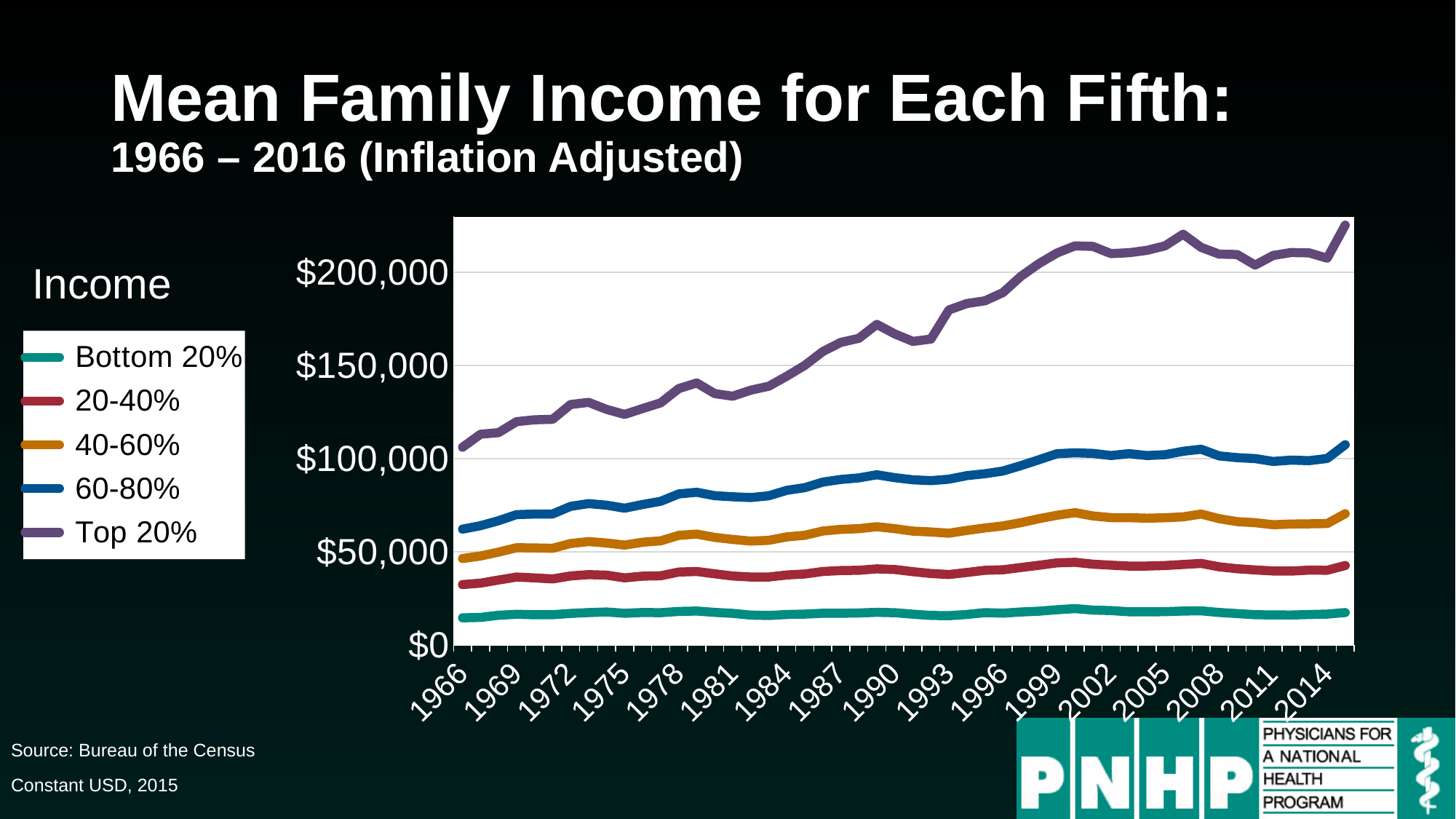
How many series does the legend list? 5 What is the title of the legend on the slide? Income Is the value for the 40-60% group in 2016 greater or less than $100,000? less Which income group has the lowest mean family income across the whole period? Bottom 20% Is the value for the 60-80% group in 1966 greater or less than $100,000? less Which is larger in 2016: the mean family income of the Top 20% or of the 60-80% group? Top 20% Does the mean family income of the Top 20% generally rise or fall from 1966 to 2016? Rise Is the value for the Top 20% in 1966 greater or less than $100,000? greater What kind of chart is shown on the slide? Line chart Which income group has the highest mean family income across the whole period? Top 20%